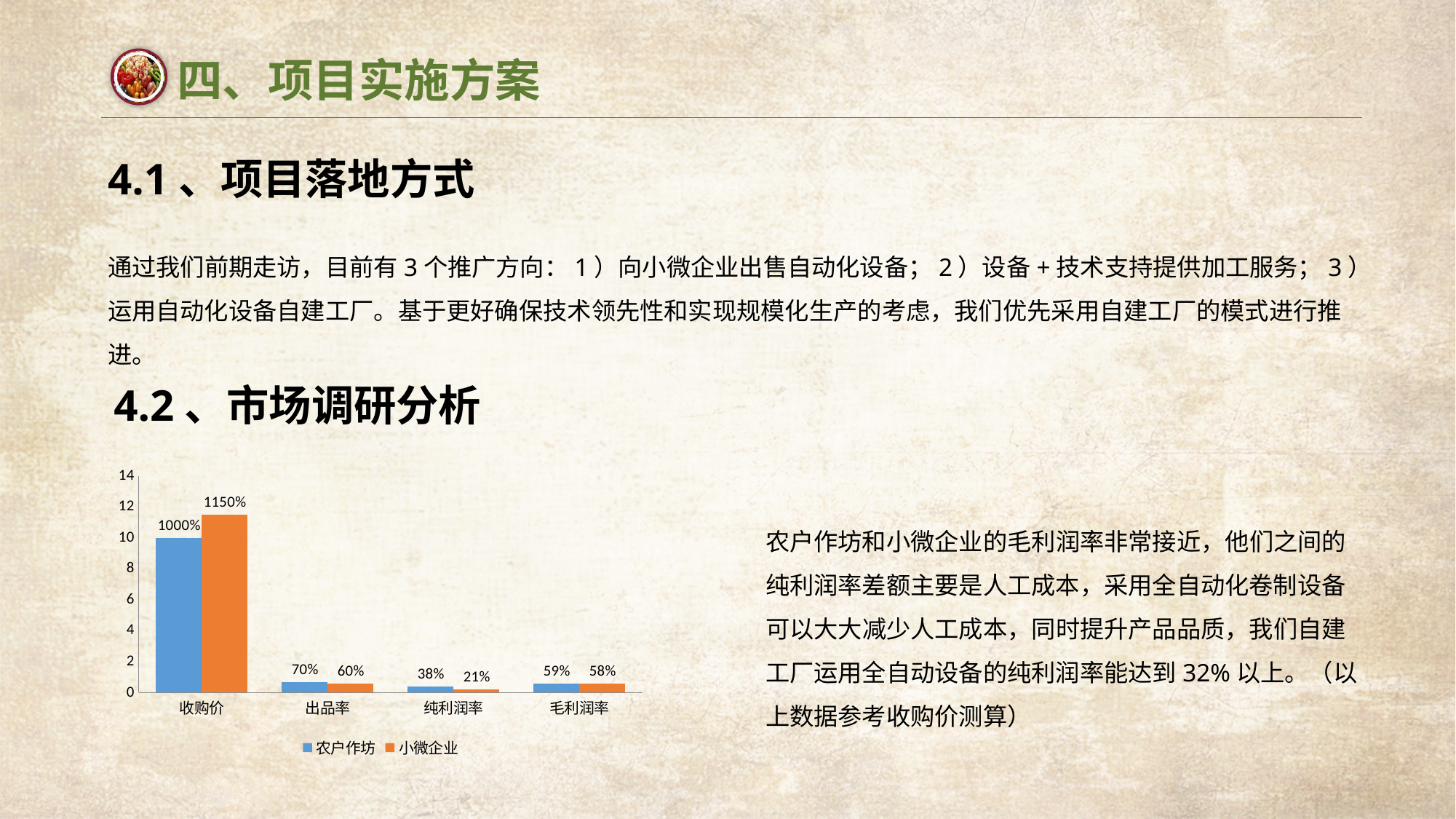
What is the value for 小微企业 in the 出品率 category? 60% Which category has the lowest value for 小微企业? 纯利润率 What is the value for 农户作坊 in the 纯利润率 category? 38% What is the difference between the 小微企业 and 农户作坊 values in the 收购价 category? 150% What kind of chart is shown on the slide? Bar chart How many series does the chart legend list? 2 What is the value for 小微企业 in the 收购价 category? 1150% How many categories are shown on the x axis of the chart? 4 Which category has the highest value for 小微企业? 收购价 In the 出品率 category, which series has the larger value, 农户作坊 or 小微企业? 农户作坊 What is the value for 农户作坊 in the 收购价 category? 1000% What is the difference between the 农户作坊 and 小微企业 values in the 纯利润率 category? 17%